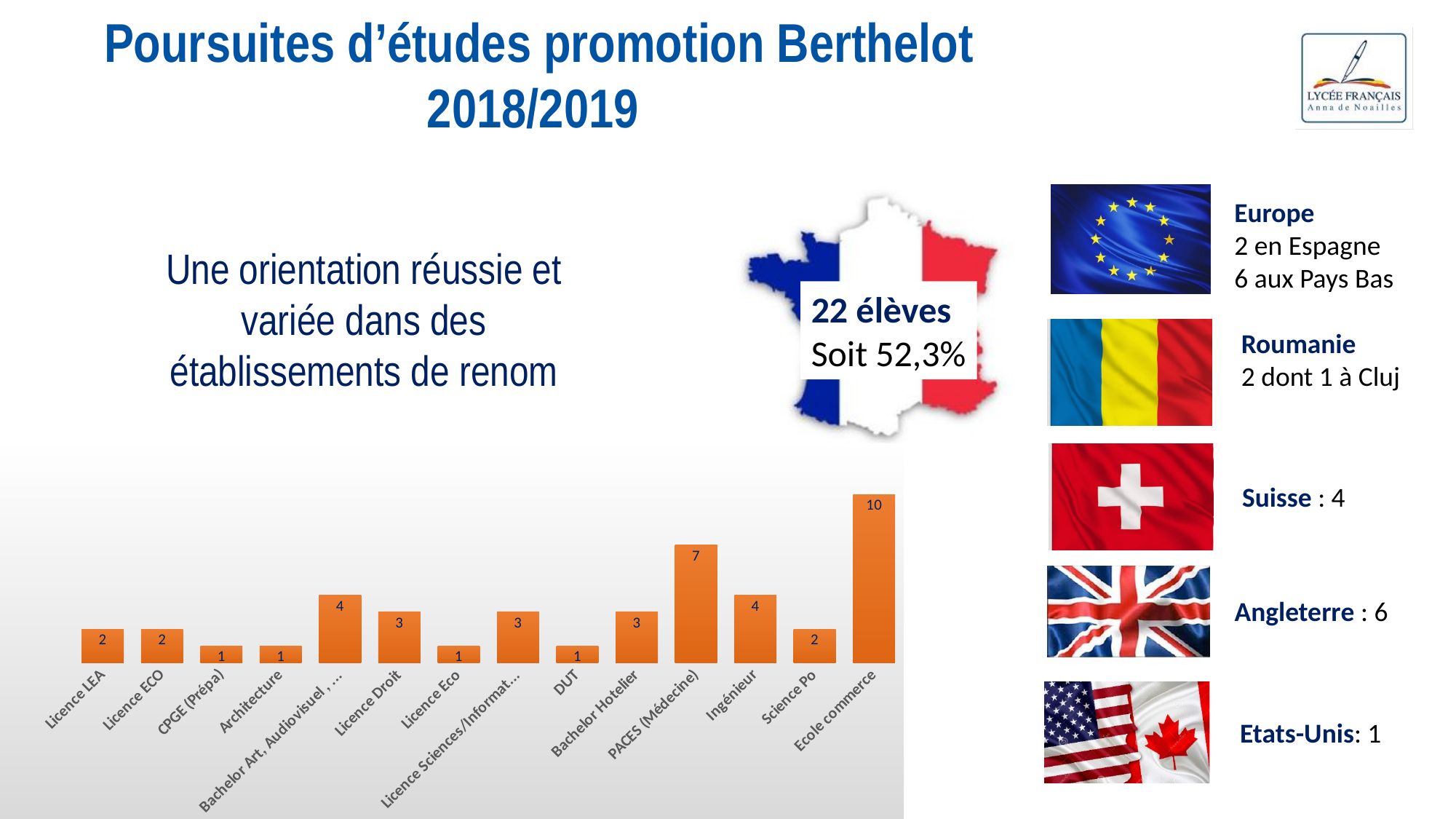
What is the difference between the values for Ecole commerce and PACES (Médecine)? 3 What is the difference between the values for Ingénieur and DUT? 3 What is the value for Licence Droit? 3 What is the value for Architecture? 1 What type of chart is shown on the slide? bar chart What is the value for PACES (Médecine)? 7 Which category has the highest value? Ecole commerce What colour are the bars in the chart? orange What is the value for Ecole commerce? 10 What is the value for Science Po? 2 How many categories does the bar chart show? 14 Which is larger, the value for Ingénieur or the value for Bachelor Hotelier? Ingénieur